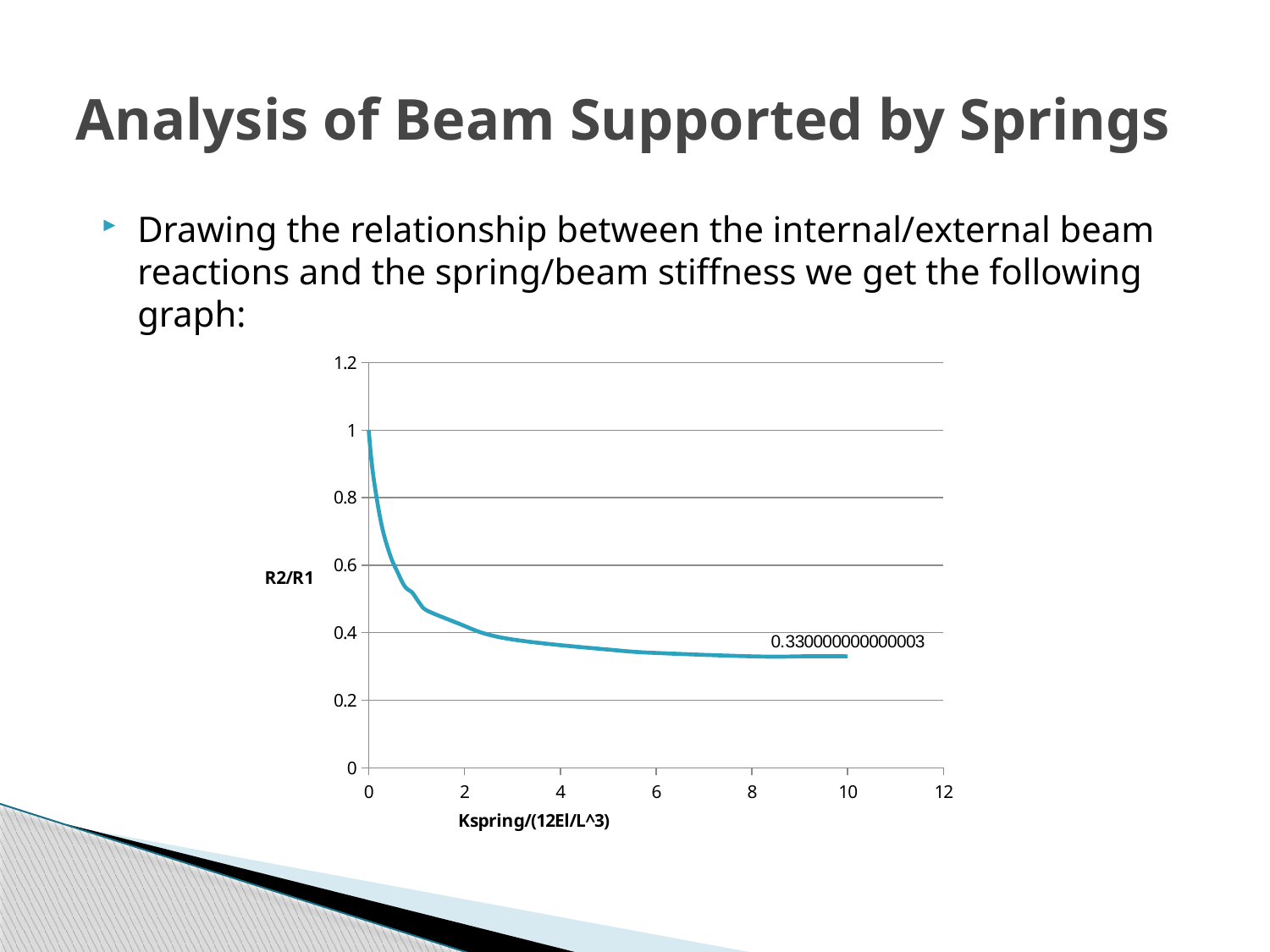
What kind of chart is shown on the slide? line chart Is R2/R1 at Kspring/(12EI/L^3) = 6 greater or less than 0.4? less What is the title of the y axis of the chart? R2/R1 What is the value of R2/R1 at Kspring/(12EI/L^3) = 0? 1 Is R2/R1 at Kspring/(12EI/L^3) = 1 greater or less than 0.6? less At which value of Kspring/(12EI/L^3) is R2/R1 highest? 0 Does R2/R1 rise or fall as Kspring/(12EI/L^3) increases along the x axis? fall What is the title of the x axis of the chart? Kspring/(12EI/L^3) Which is larger, R2/R1 at Kspring/(12EI/L^3) = 2 or at Kspring/(12EI/L^3) = 8? at 2 What is the value of R2/R1 at the labelled point at Kspring/(12EI/L^3) = 10? 0.330000000000003 Is R2/R1 at Kspring/(12EI/L^3) = 1 greater or less than 0.4? greater